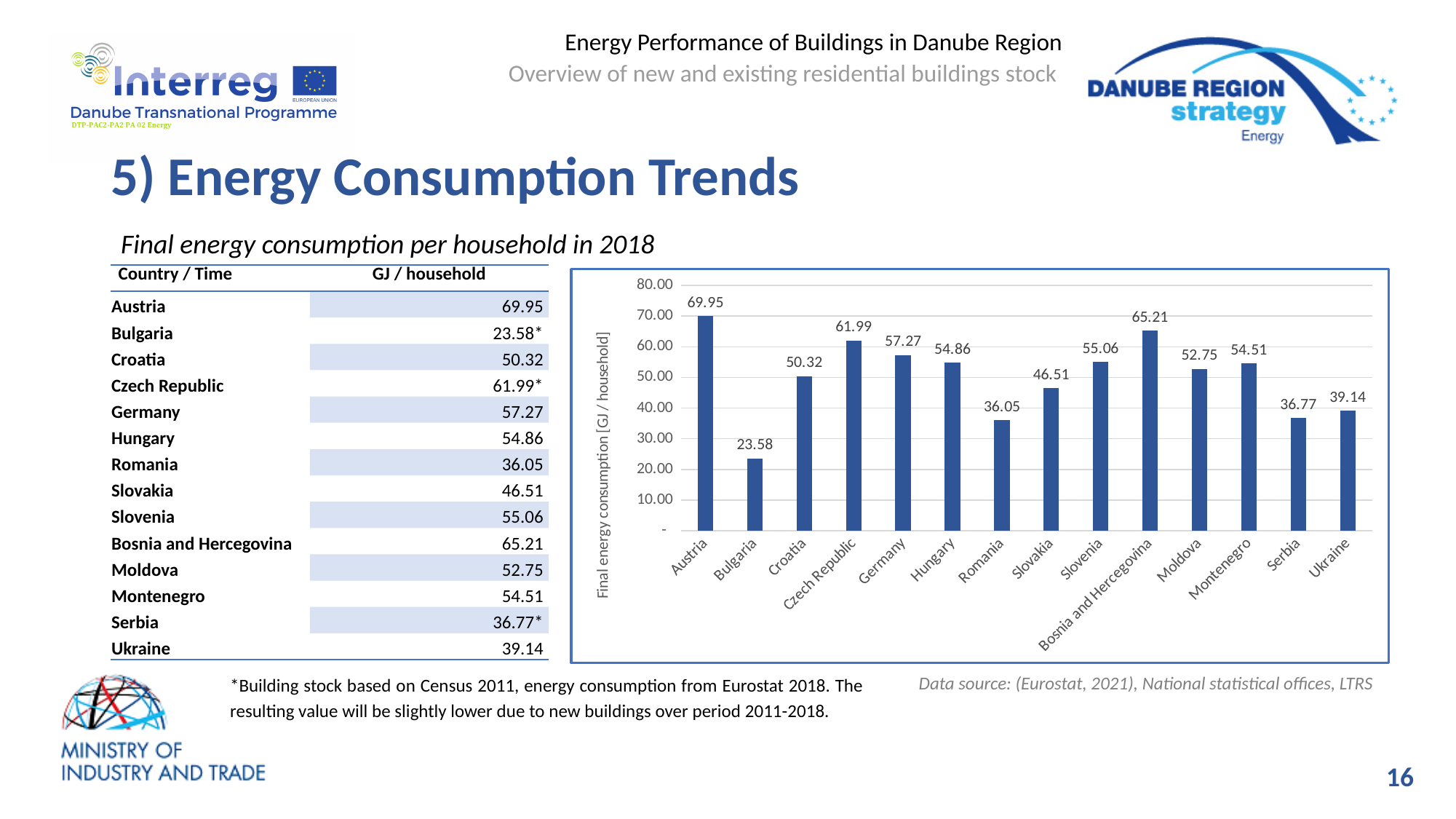
What is the value for Moldova in the bar chart? 52.75 Which country has the lowest value in the bar chart? Bulgaria Which has a larger value in the bar chart, Czech Republic or Bosnia and Hercegovina? Bosnia and Hercegovina Is the value for Romania in the bar chart greater or less than 40.00? less What is the value for Austria in the bar chart? 69.95 What is the value for Bosnia and Hercegovina in the bar chart? 65.21 What is the label of the vertical axis of the bar chart? Final energy consumption [GJ / household] What is the difference between the values for Germany and Hungary in the bar chart? 2.41 What kind of chart is shown on the slide? bar chart Which country has the highest value in the bar chart? Austria What is the difference between the values for Austria and Bulgaria in the bar chart? 46.37 How many countries are shown in the bar chart? 14